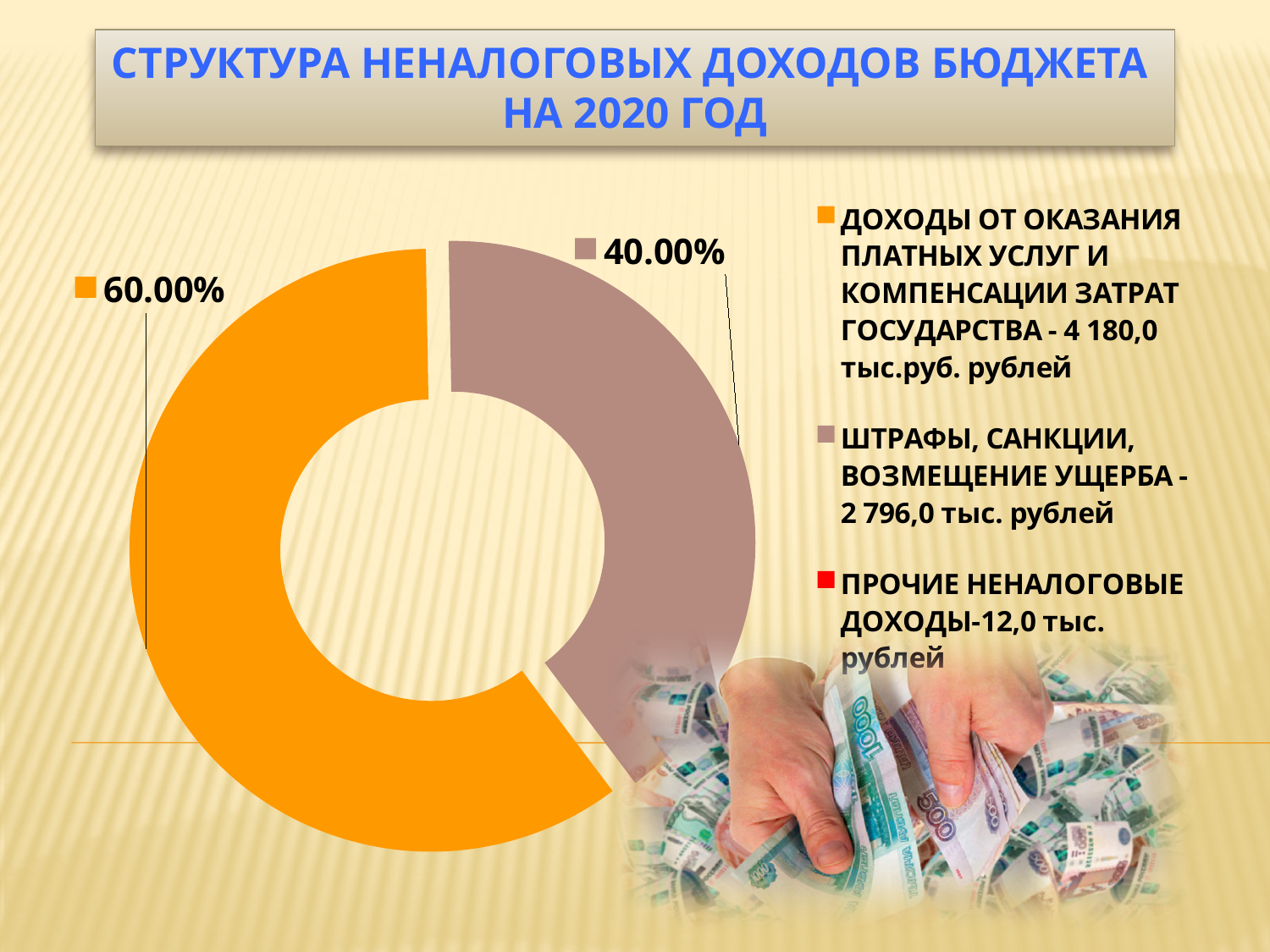
Which is larger: the share for ДОХОДЫ ОТ ОКАЗАНИЯ ПЛАТНЫХ УСЛУГ or the share for ШТРАФЫ, САНКЦИИ, ВОЗМЕЩЕНИЕ УЩЕРБА? ДОХОДЫ ОТ ОКАЗАНИЯ ПЛАТНЫХ УСЛУГ What share of the chart does the orange slice (ДОХОДЫ ОТ ОКАЗАНИЯ ПЛАТНЫХ УСЛУГ И КОМПЕНСАЦИИ ЗАТРАТ ГОСУДАРСТВА) represent? 60.00% What share of the chart does the slice for ШТРАФЫ, САНКЦИИ, ВОЗМЕЩЕНИЕ УЩЕРБА represent? 40.00% How many entries does the legend list? 3 Which category has the largest share in the chart? ДОХОДЫ ОТ ОКАЗАНИЯ ПЛАТНЫХ УСЛУГ И КОМПЕНСАЦИИ ЗАТРАТ ГОСУДАРСТВА According to the legend, what is the amount for ШТРАФЫ, САНКЦИИ, ВОЗМЕЩЕНИЕ УЩЕРБА? 2 796,0 тыс. рублей What colour is the slice representing ШТРАФЫ, САНКЦИИ, ВОЗМЕЩЕНИЕ УЩЕРБА? Brown (greyish-brown) What is the difference in percentage points between the 60.00% slice and the 40.00% slice? 20 percentage points According to the legend, what is the amount for ПРОЧИЕ НЕНАЛОГОВЫЕ ДОХОДЫ? 12,0 тыс. рублей Is the share of the orange slice greater or less than 50%? greater What kind of chart is shown on the slide? Doughnut (pie) chart What is the title of the slide? СТРУКТУРА НЕНАЛОГОВЫХ ДОХОДОВ БЮДЖЕТА НА 2020 ГОД